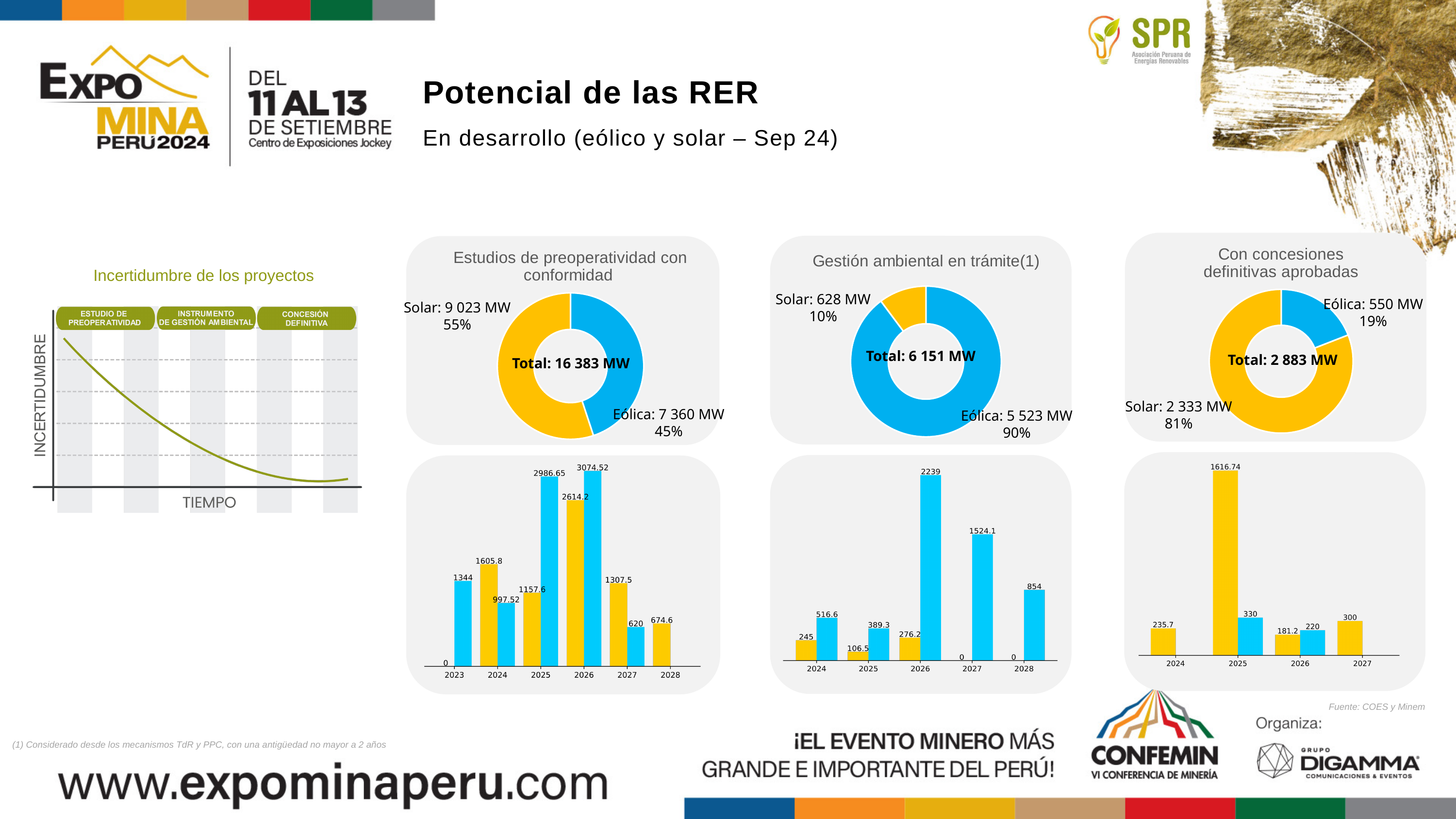
In the 'Gestión ambiental en trámite(1)' donut chart, what is the value for Eólica? 5 523 MW In the bar chart below 'Gestión ambiental en trámite(1)', what is the value of the yellow bar for 2025? 106.5 In the bar chart below 'Gestión ambiental en trámite(1)', which year has the highest bar? 2026 In the bar chart below 'Estudios de preoperatividad con conformidad', what is the value of the blue bar for 2026? 3074.52 In the bar chart below 'Con concesiones definitivas aprobadas', what is the value of the yellow bar for 2025? 1616.74 In the 'Con concesiones definitivas aprobadas' donut chart, what is the difference between the Solar and Eólica values? 1 783 MW In the 'Estudios de preoperatividad con conformidad' donut chart, what is the total shown in the centre? 16 383 MW In the 'Gestión ambiental en trámite(1)' donut chart, which segment is larger, Solar or Eólica? Eólica In the 'Con concesiones definitivas aprobadas' donut chart, what share does Eólica have? 19% What type of chart is used for the three charts in the bottom row of the slide? Bar chart In the 'Estudios de preoperatividad con conformidad' donut chart, what share does Solar have? 55% In the bar chart below 'Estudios de preoperatividad con conformidad', how many years are shown on the x axis? 6